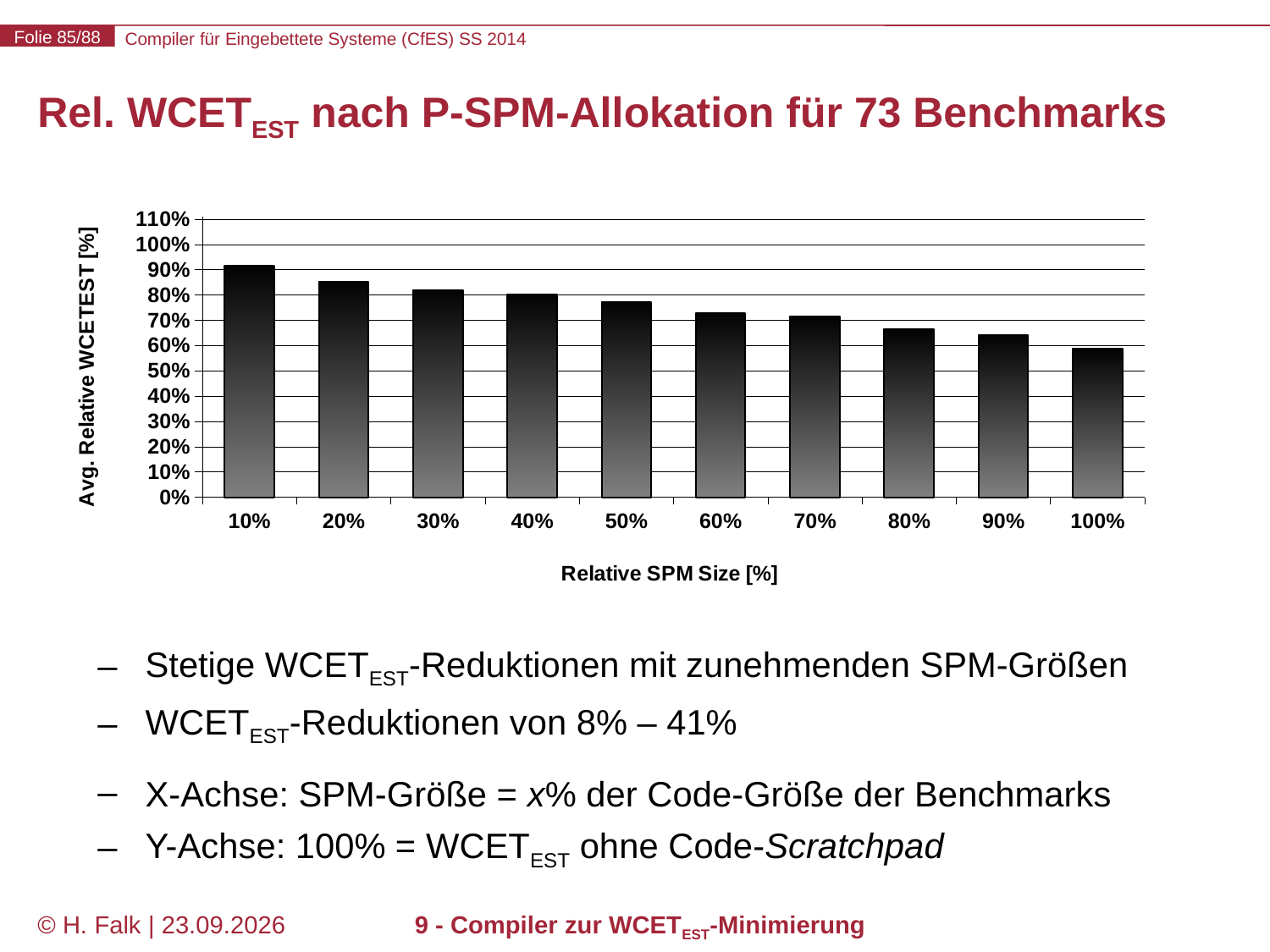
What kind of chart is shown on the slide? bar chart Is the average relative WCETEST for a relative SPM size of 80% greater or less than 70%? less Do the values rise or fall as the relative SPM size increases along the x axis? fall Which has a larger average relative WCETEST: a relative SPM size of 20% or 60%? 20% How many bars (relative SPM size categories) are plotted in the chart? 10 What is the label of the x axis of the chart? Relative SPM Size [%] Is the average relative WCETEST for a relative SPM size of 50% greater or less than 70%? greater Which relative SPM size has the lowest average relative WCETEST? 100% What is the label of the y axis of the chart? Avg. Relative WCETEST [%] Which relative SPM size has the highest average relative WCETEST? 10%